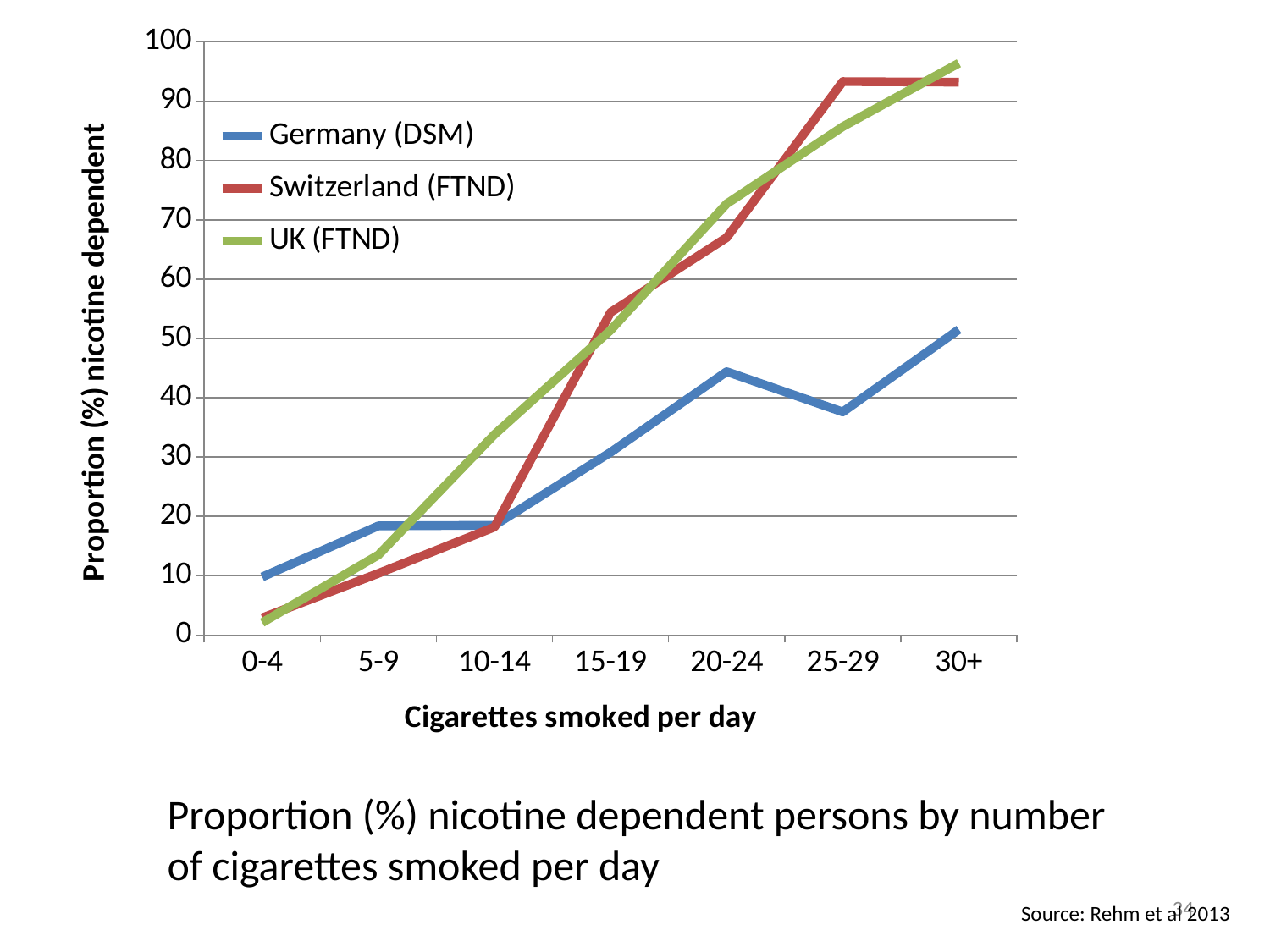
What is the title of the x axis? Cigarettes smoked per day For which category is the Germany (DSM) value highest? 30+ For which category is the Germany (DSM) value lowest? 0-4 How many categories are shown on the x axis? 7 Is the value for Germany (DSM) at 30+ cigarettes per day greater or less than 40? greater At 5-9 cigarettes per day, which is larger: Germany (DSM) or Switzerland (FTND)? Germany (DSM) At 20-24 cigarettes per day, which is larger: Switzerland (FTND) or Germany (DSM)? Switzerland (FTND) How many series does the legend list? 3 Is the value for UK (FTND) at 10-14 cigarettes per day greater or less than 40? less What kind of chart is shown on the slide? line chart Is the value for Switzerland (FTND) at 25-29 cigarettes per day greater or less than 80? greater Does the Switzerland (FTND) line generally rise or fall as cigarettes smoked per day increases? rise